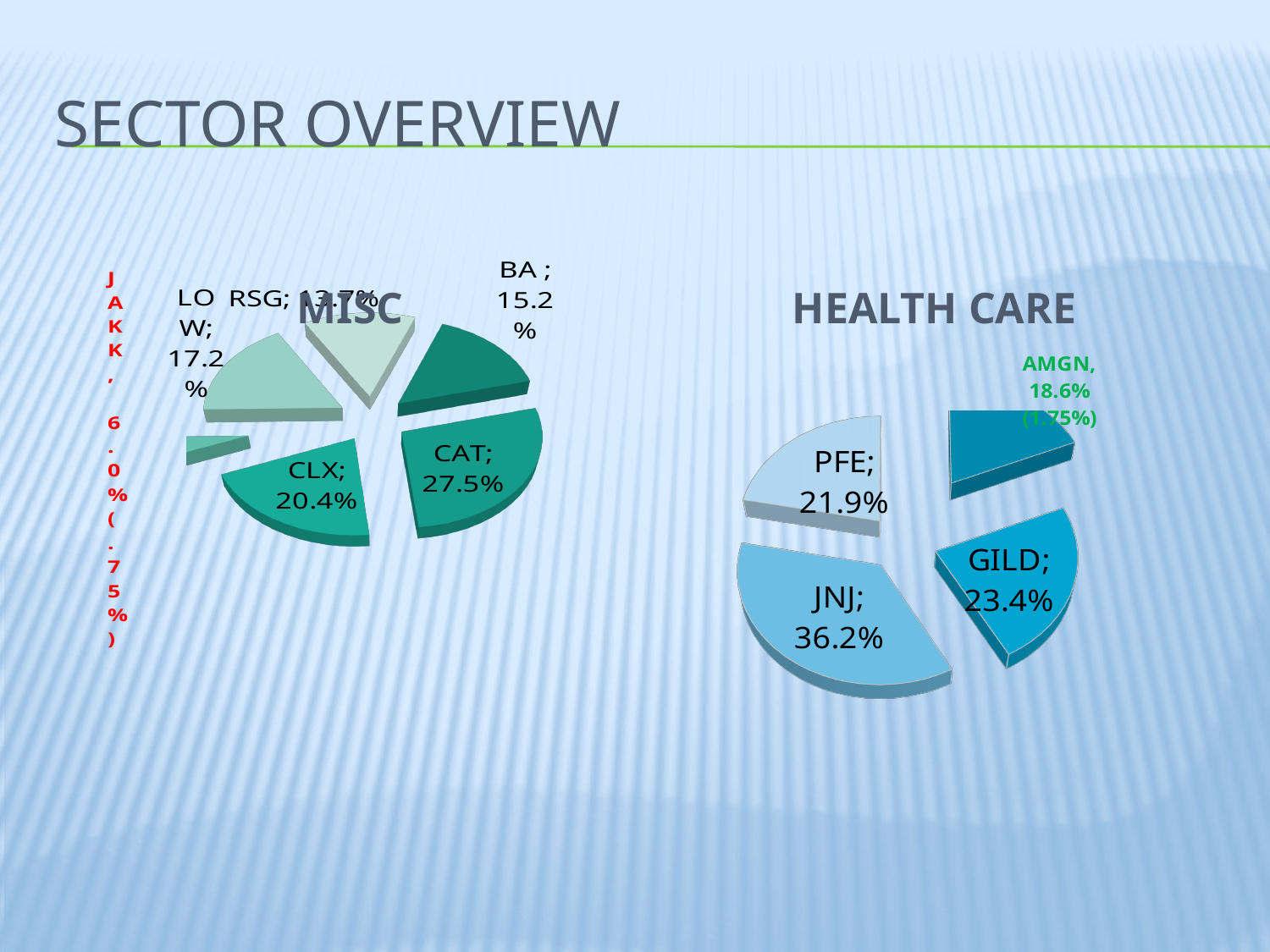
In the HEALTH CARE chart, what percentage is shown for GILD? 23.4% In the MISC chart, what percentage is shown for BA? 15.2% In the HEALTH CARE chart, what percentage is shown for JNJ? 36.2% What kind of chart is the HEALTH CARE chart? Pie chart In the MISC chart, what percentage is shown for CAT? 27.5% In the HEALTH CARE chart, which company has the smallest slice? AMGN How many slices does the HEALTH CARE chart have? 4 In the HEALTH CARE chart, which company has the largest slice? JNJ In the HEALTH CARE chart, what is the difference between the JNJ and PFE percentages? 14.3% In the MISC chart, what percentage is shown for CLX? 20.4% In the MISC chart, which company has the largest slice? CAT In the MISC chart, which is larger, CAT or CLX? CAT